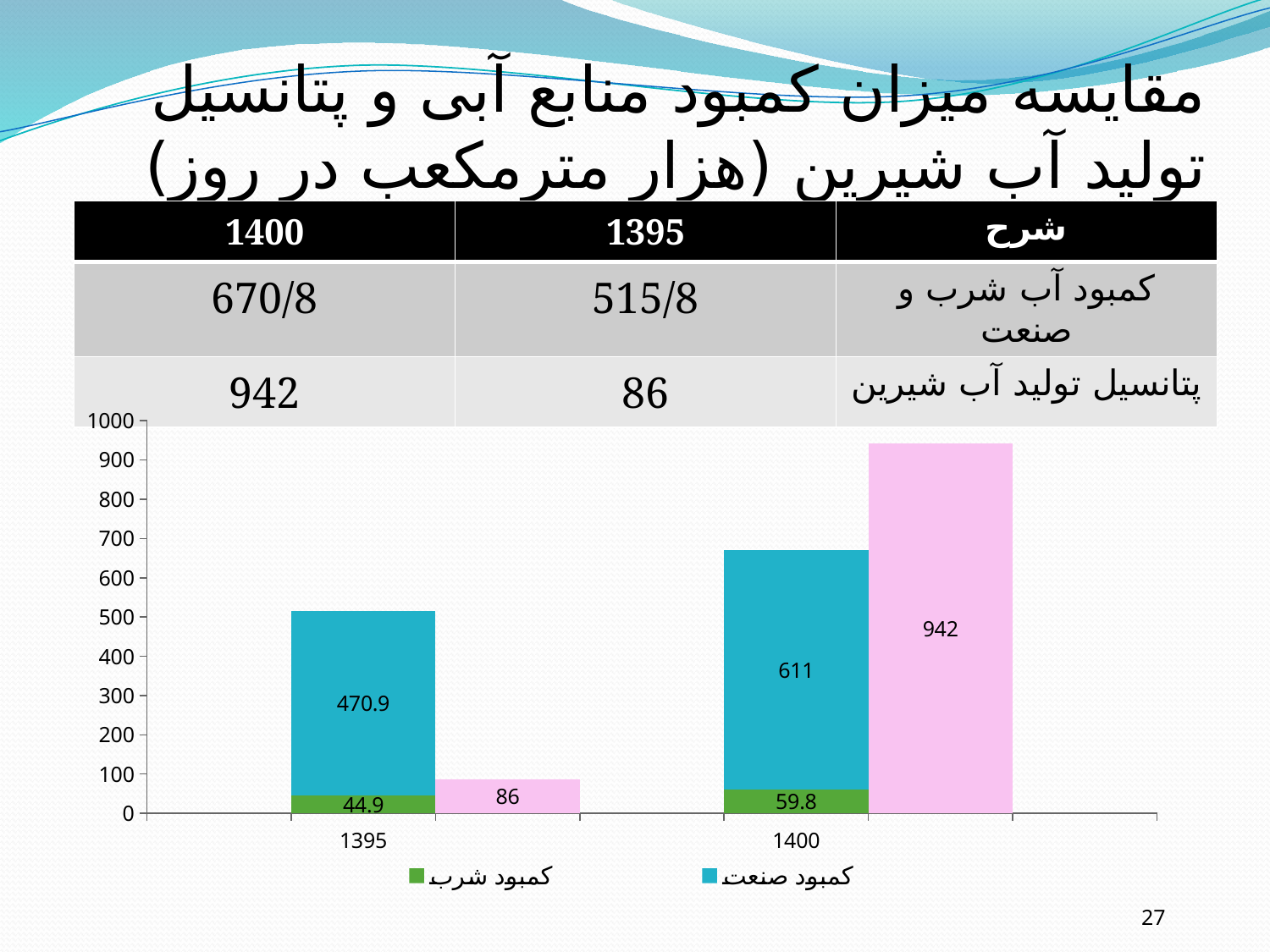
What is the value of کمبود صنعت for 1400? 611 How many year categories are shown on the x axis? 2 Which year has the larger کمبود شرب value, 1395 or 1400? 1400 What is the total of the stacked bar (کمبود شرب plus کمبود صنعت) for 1395? 515.8 What is the total of the stacked bar (کمبود شرب plus کمبود صنعت) for 1400? 670.8 What is the value of کمبود شرب for 1400? 59.8 What is the difference between the کمبود صنعت values for 1400 and 1395? 140.1 How many series does the legend list? 2 What value is labelled on the pink bar for 1400? 942 What kind of chart is shown on the slide? Stacked bar chart Does the کمبود صنعت value rise or fall from 1395 to 1400? Rise What is the value of کمبود صنعت for 1395? 470.9